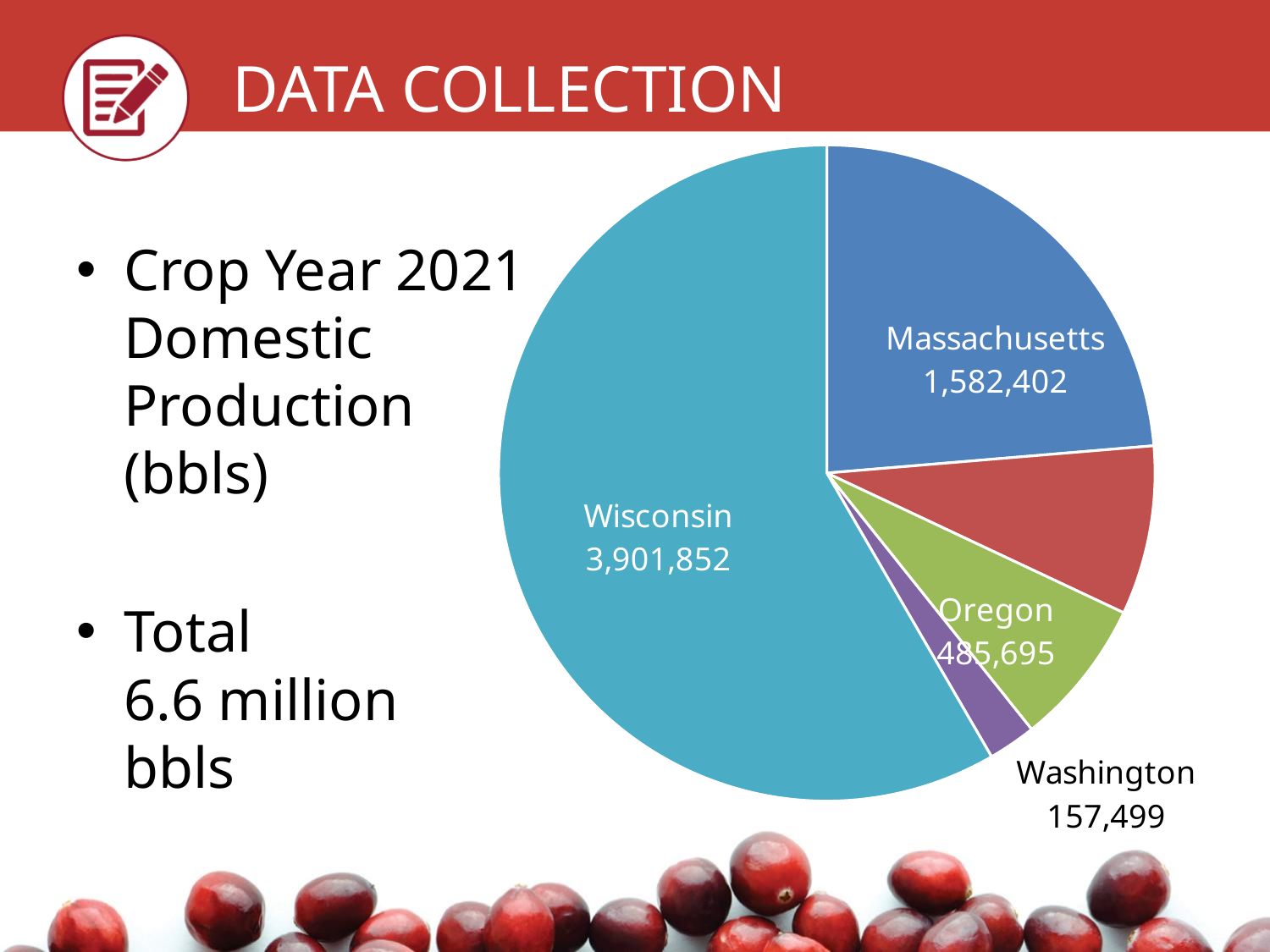
What is the production value shown for Oregon? 485,695 What is the difference between the values for Wisconsin and Massachusetts? 2,319,450 What is the production value shown for Massachusetts? 1,582,402 Which state has the largest slice of the pie? Wisconsin What is the difference between the values for Oregon and Washington? 328,196 What is the production value shown for Washington? 157,499 What kind of chart is shown on the slide? pie chart Which labeled state has the smallest slice of the pie? Washington What colour is the Wisconsin slice? teal (light blue) What is the production value shown for Wisconsin? 3,901,852 Which is larger, the value for Massachusetts or the value for Oregon? Massachusetts How many slices does the pie chart have? 5